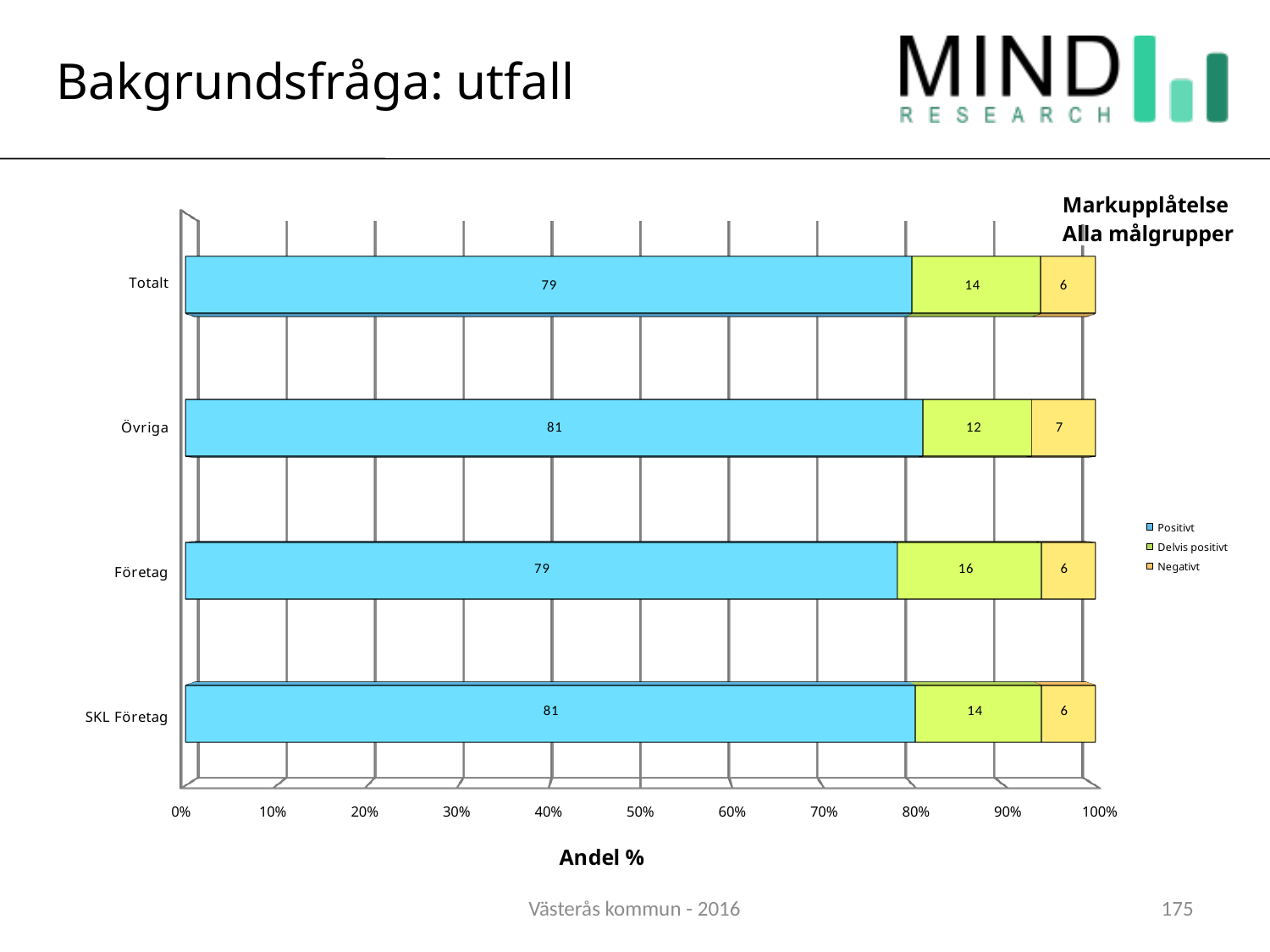
Is the Positivt value for Övriga larger or smaller than the Positivt value for Företag? Larger What is the Positivt value for SKL Företag? 81 What is the Delvis positivt value for Företag? 16 What is the Positivt value for Totalt? 79 Which category has the lowest Delvis positivt value? Övriga What is the Negativt value for Övriga? 7 What kind of chart is shown on the slide? Stacked bar chart How many categories are shown on the vertical axis? 4 How many series does the legend list? 3 What is the title of the x axis? Andel % Which category has the highest Delvis positivt value? Företag What is the difference between the Delvis positivt values for Företag and Övriga? 4